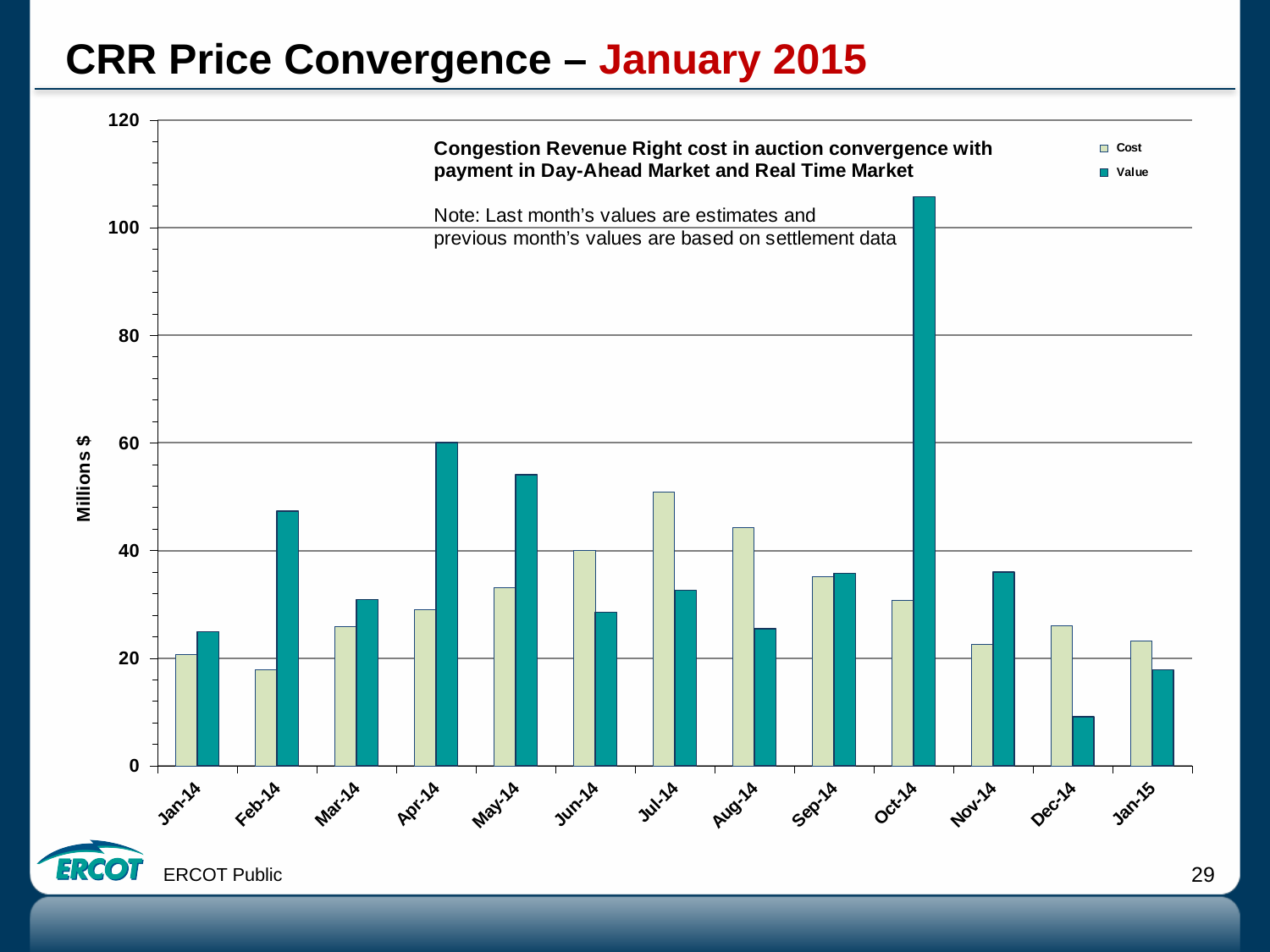
How many months are shown on the x axis? 13 Is the Cost for Jul-14 greater or less than 40? greater Which month has the lowest Cost bar? Feb-14 Which month has the highest Value bar? Oct-14 Which month has the highest Cost bar? Jul-14 Is the Value for Oct-14 greater or less than 100? greater For Feb-14, which is larger, Cost or Value? Value Is the Value for Dec-14 greater or less than 20? less What kind of chart is shown on the slide? bar chart Which month has the lowest Value bar? Dec-14 What is the label of the y axis? Millions $ How many series does the legend list? 2